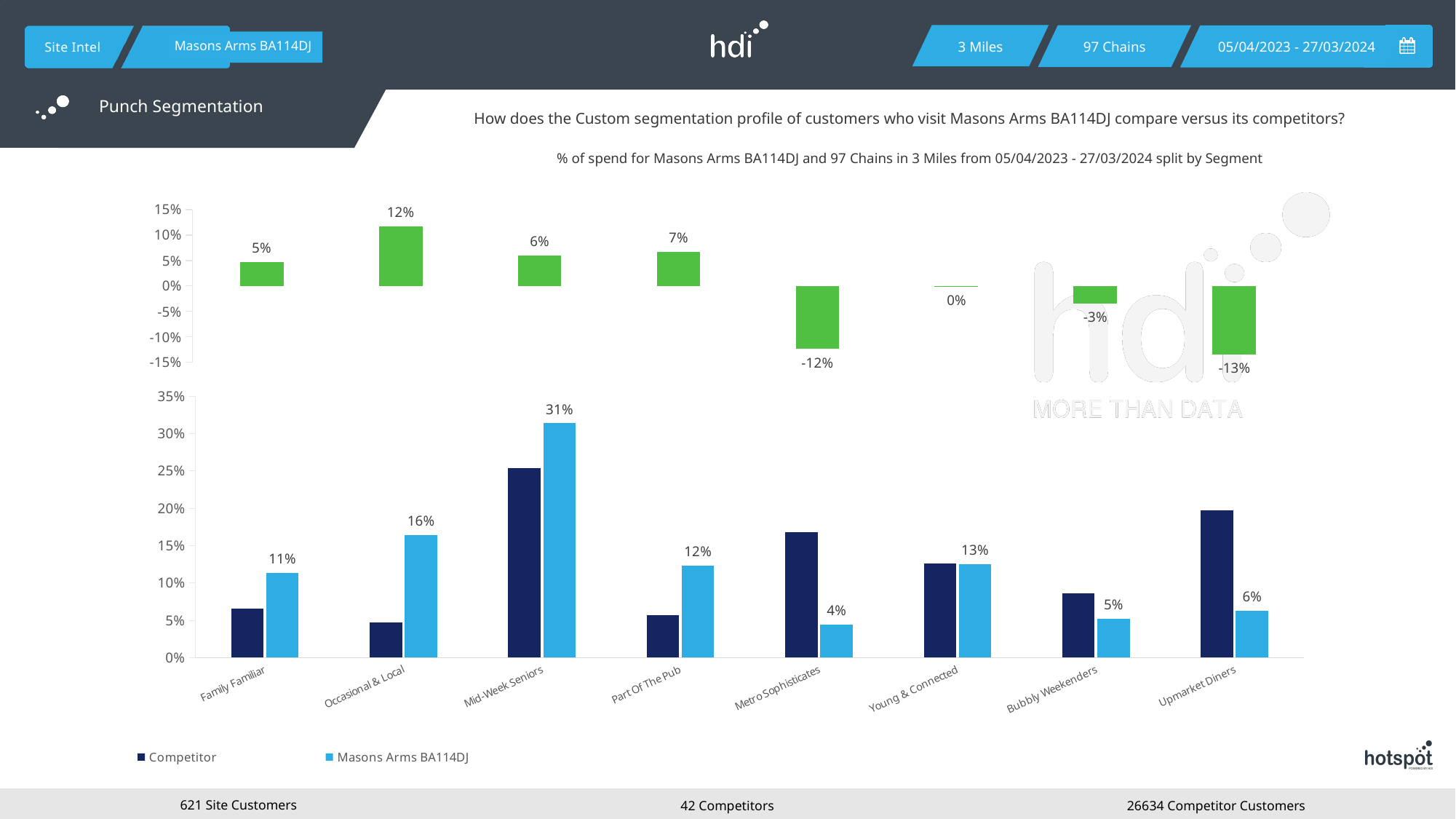
In the bottom chart, which is larger for Metro Sophisticates: the Competitor value or the Masons Arms BA114DJ value? Competitor In the bottom chart, which segment has the lowest value for Masons Arms BA114DJ? Metro Sophisticates In the bottom chart, is the Competitor value for Upmarket Diners greater or less than 15%? greater In the bottom chart, which segment has the highest value for Masons Arms BA114DJ? Mid-Week Seniors In the bottom chart, what is the difference between the Masons Arms BA114DJ values for Mid-Week Seniors and Family Familiar? 20% How many series does the legend of the bottom chart list? 2 In the top chart, what is the value for Upmarket Diners? -13% In the bottom chart, what is the value for Masons Arms BA114DJ in the Mid-Week Seniors segment? 31% How many segments are shown on the x axis of the bottom chart? 8 In the bottom chart, what is the value for Masons Arms BA114DJ in the Occasional & Local segment? 16% In the top chart, which segment has the highest value? Occasional & Local In the bottom chart, is the Competitor value for Occasional & Local greater or less than 10%? less